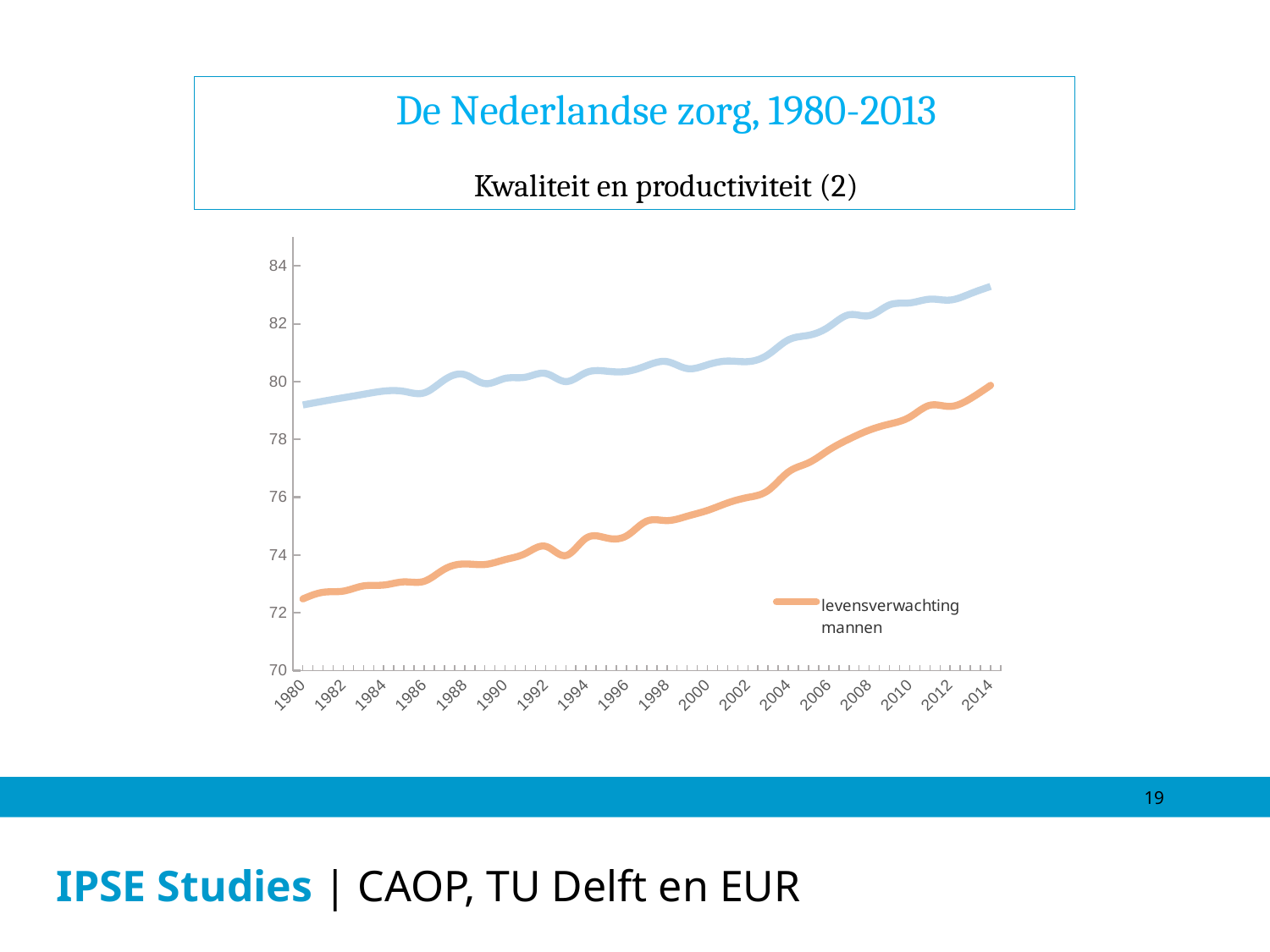
Is the value for 'levensverwachting mannen' in 2013 greater or less than 78? greater Is the value of the upper (light blue) line in 1980 greater or less than 80? less In 2006, which line is higher: the light blue line or the 'levensverwachting mannen' line? the light blue line Does the 'levensverwachting mannen' line rise or fall from 1980 to 2013? rise What is the first year shown on the x axis? 1980 How many series does the legend list? 1 What is the name of the series shown in the legend? levensverwachting mannen Is the value for 'levensverwachting mannen' in 1980 greater or less than 74? less Does the upper (light blue) line rise or fall across the years shown? rise What kind of chart is shown on the slide? line chart